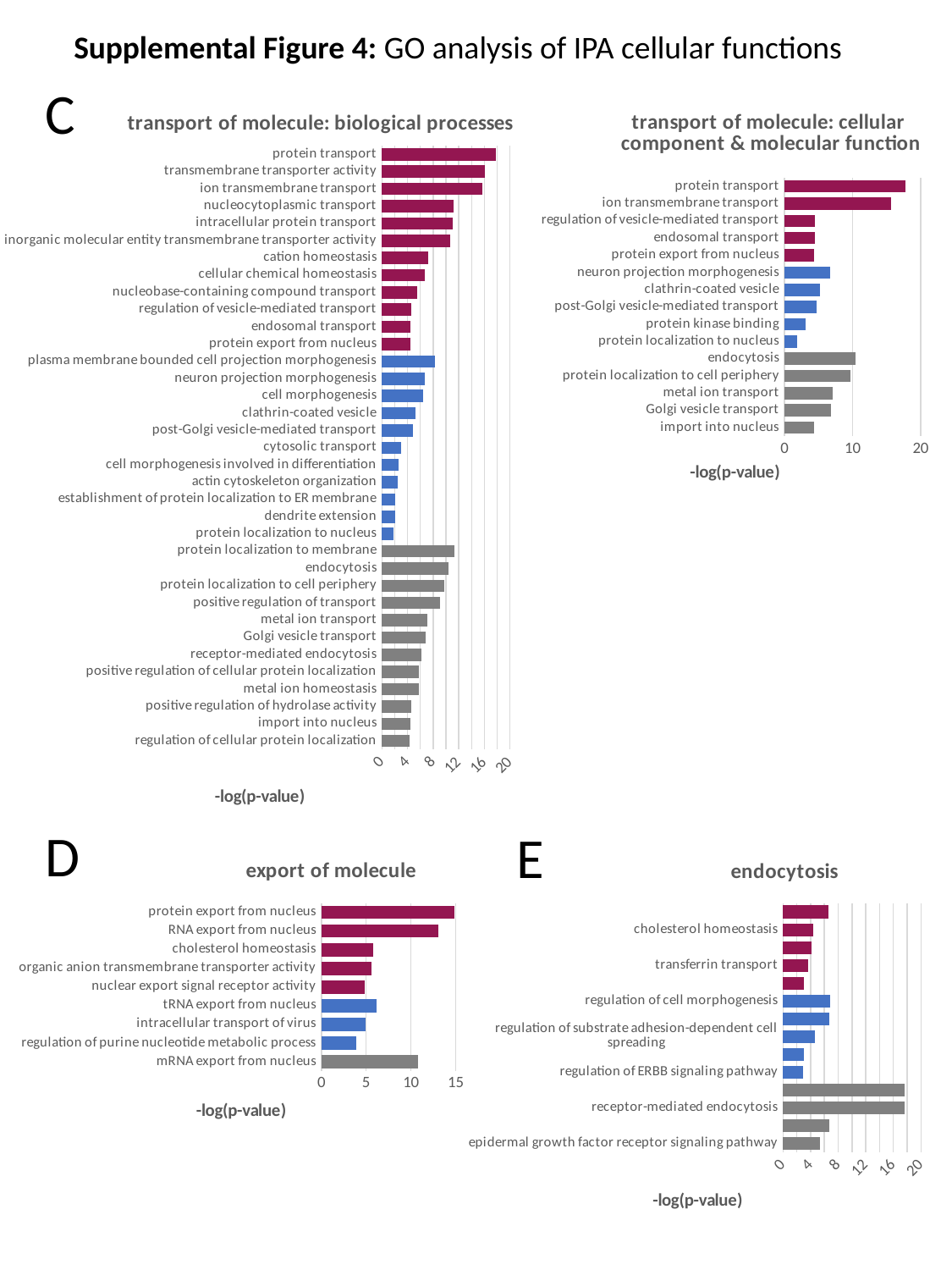
In the chart titled 'transport of molecule: biological processes', which is larger, the value for protein transport or the value for endocytosis? protein transport In the chart titled 'export of molecule', is the value for mRNA export from nucleus greater or less than 10? greater In the chart titled 'export of molecule', which category has the highest -log(p-value)? protein export from nucleus In the chart titled 'transport of molecule: biological processes', is the value for protein transport greater or less than 16? greater In the chart titled 'transport of molecule: biological processes', which category has the highest -log(p-value)? protein transport In the chart titled 'transport of molecule: cellular component & molecular function', which category has the lowest -log(p-value)? protein localization to nucleus In the chart titled 'export of molecule', how many categories are plotted? 9 In the chart titled 'endocytosis', is the value for regulation of ERBB signaling pathway greater or less than 4? less What kind of chart is the chart titled 'endocytosis'? bar chart In the chart titled 'transport of molecule: biological processes', how many categories are plotted? 35 In the chart titled 'transport of molecule: cellular component & molecular function', how many categories are plotted? 15